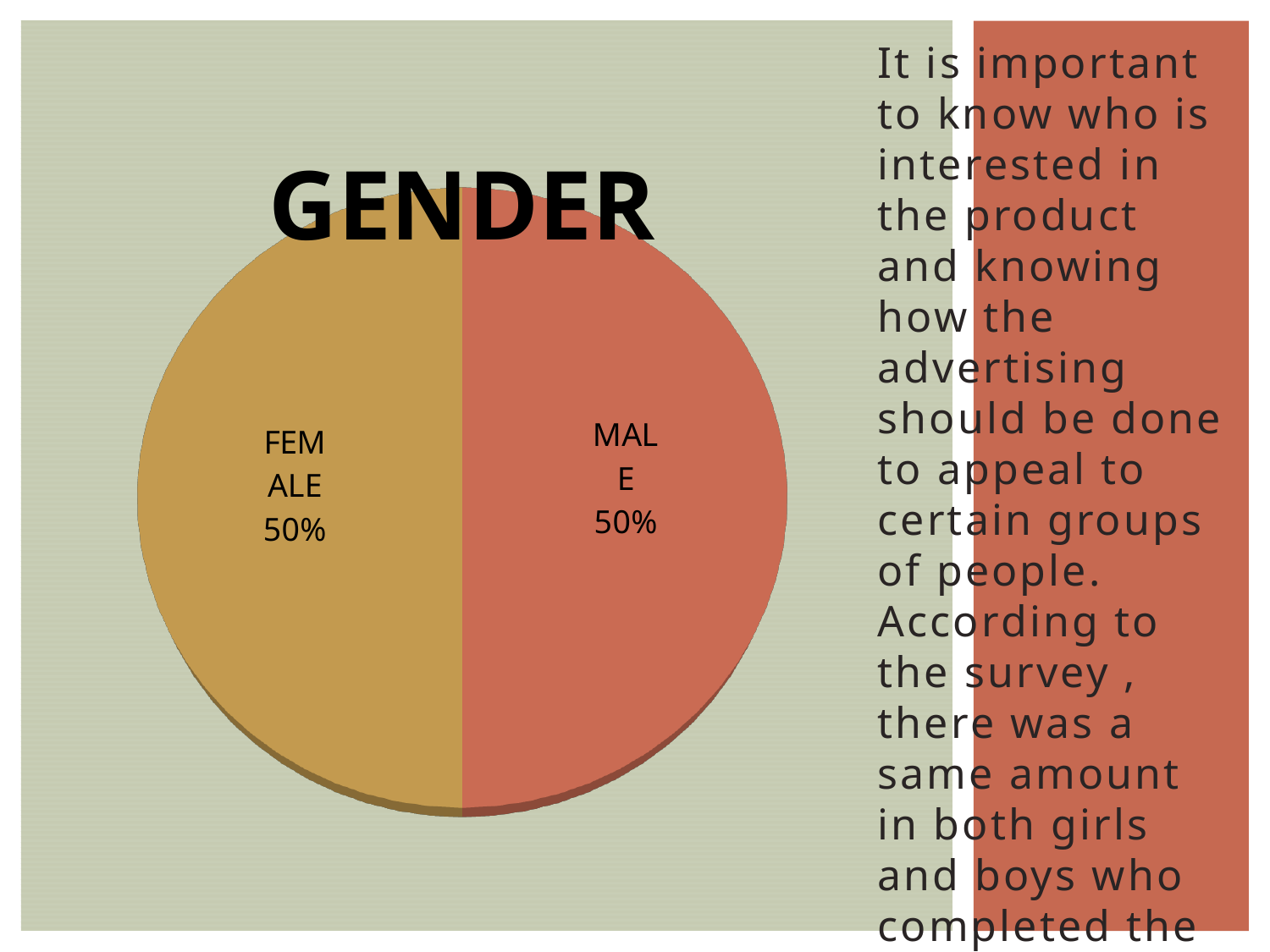
How many slices does the pie chart have? 2 What share of the pie does FEMALE represent? 50% What is the title of the chart? GENDER Which colour is the MALE slice? red What is the combined share of the FEMALE and MALE slices? 100% Is the value for MALE greater or less than 60%? less What is the difference between the FEMALE and MALE shares? 0% What kind of chart is shown on the slide? pie chart What share of the pie does MALE represent? 50% Is the value for FEMALE greater or less than 40%? greater